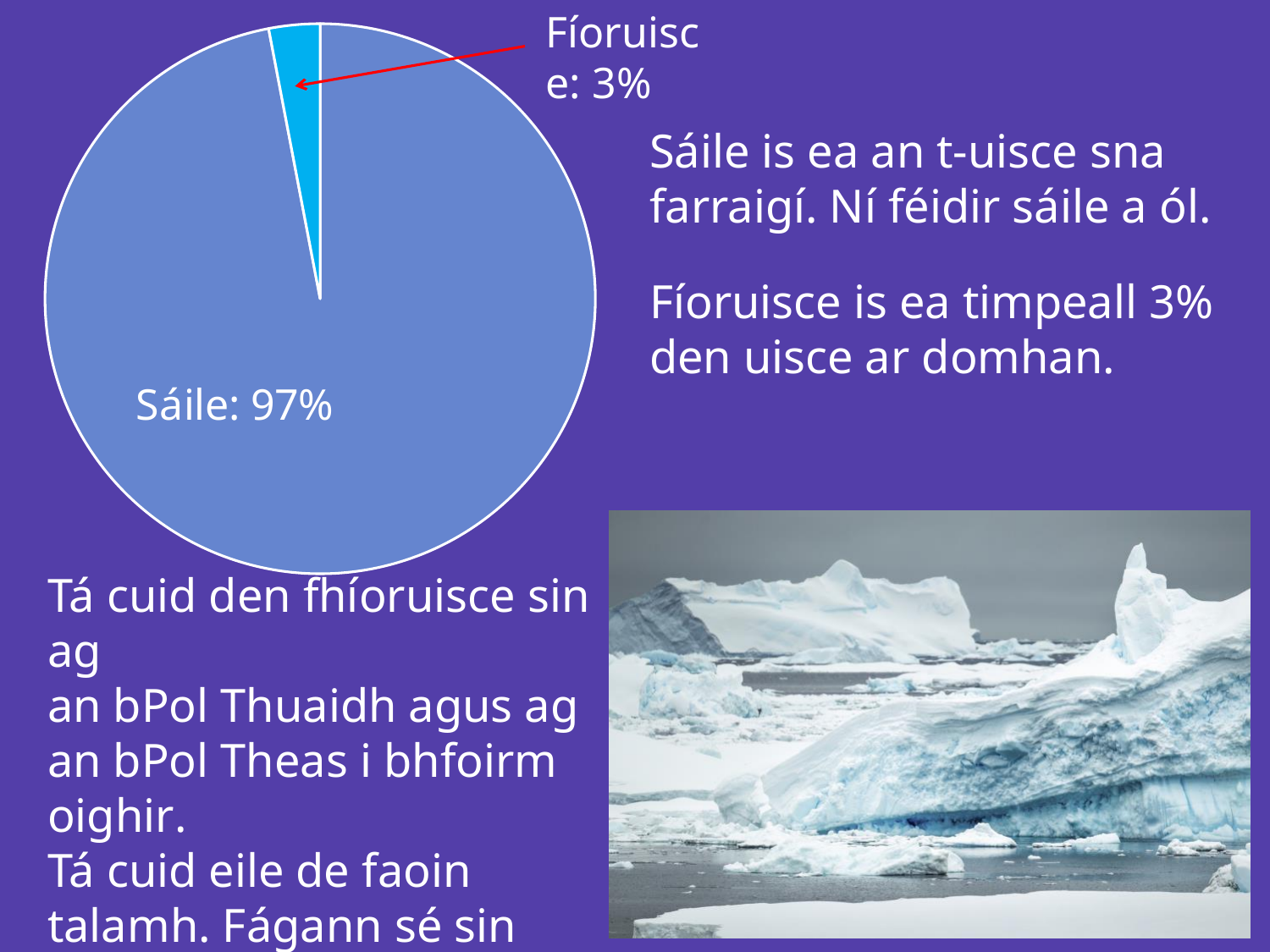
Which slice of the pie chart is the smallest? Fíoruisce What kind of chart is shown on the slide? pie chart Which slice of the pie chart is the largest? Sáile What percentage does the pie chart show for Fíoruisce? 3% What do the two slices of the pie chart add up to? 100% What percentage does the pie chart show for Sáile? 97% What share of the pie does the Fíoruisce slice represent? 3% What colour is the Fíoruisce slice in the pie chart? light blue Which is larger in the pie chart, Sáile or Fíoruisce? Sáile What is the difference in percentage points between the Sáile slice and the Fíoruisce slice? 94 How many slices does the pie chart have? 2